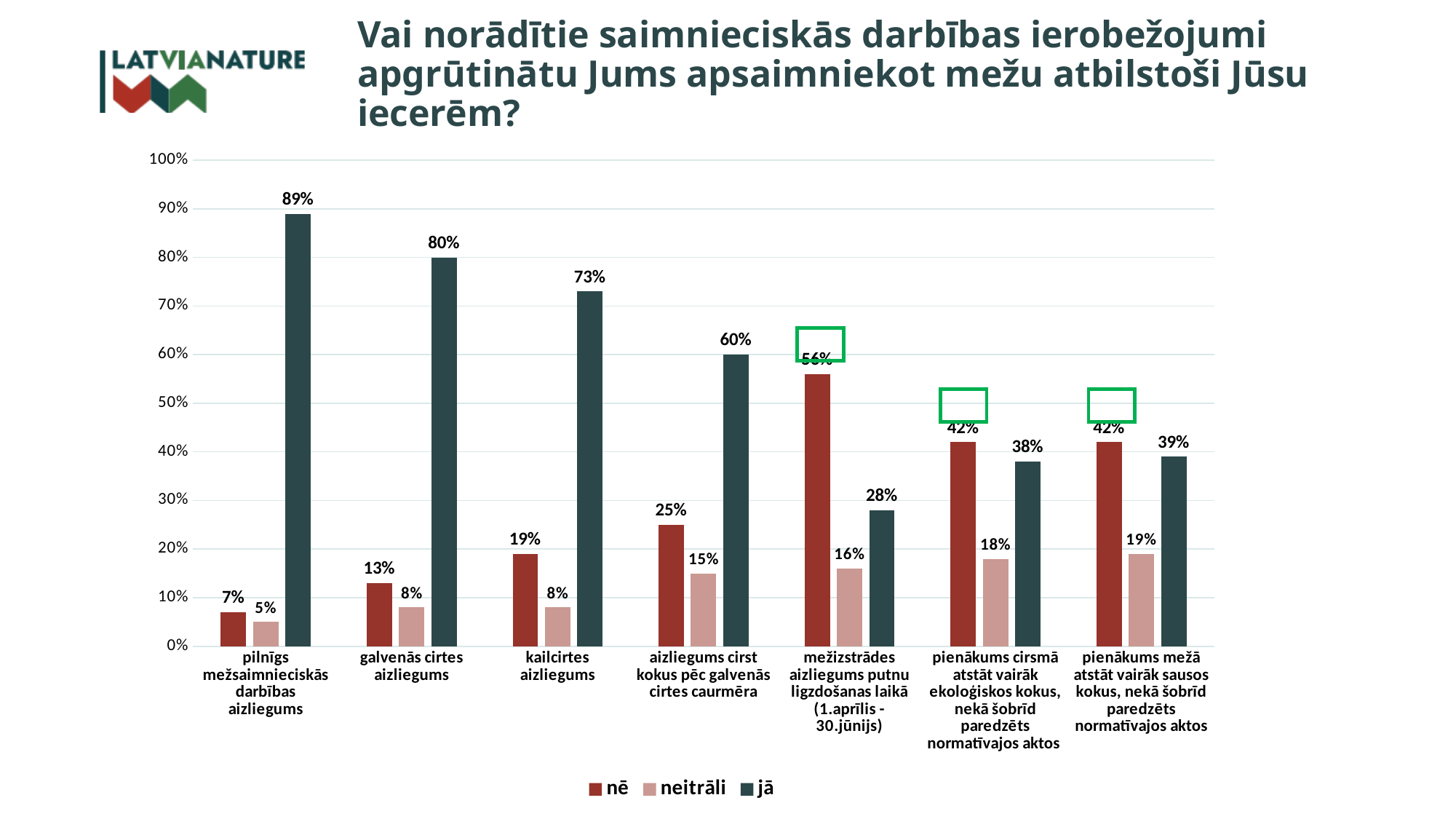
What is the 'jā' value for 'pilnīgs mežsaimnieciskās darbības aizliegums'? 89% How many categories are shown on the x axis? 7 What is the 'neitrāli' value for 'aizliegums cirst kokus pēc galvenās cirtes caurmēra'? 15% What is the difference between the 'jā' and 'nē' values for 'galvenās cirtes aizliegums'? 67 percentage points What is the 'jā' value for 'pienākums mežā atstāt vairāk sausos kokus, nekā šobrīd paredzēts normatīvajos aktos'? 39% Which has the larger 'jā' value: 'galvenās cirtes aizliegums' or 'kailcirtes aizliegums'? galvenās cirtes aizliegums Which category has the lowest 'neitrāli' value? pilnīgs mežsaimnieciskās darbības aizliegums How many series does the legend list? 3 Is the 'nē' value for 'mežizstrādes aizliegums putnu ligzdošanas laikā (1.aprīlis - 30.jūnijs)' greater or less than 50%? greater What kind of chart is shown on the slide? bar chart Which category has the highest 'jā' value? pilnīgs mežsaimnieciskās darbības aizliegums What is the 'nē' value for 'kailcirtes aizliegums'? 19%